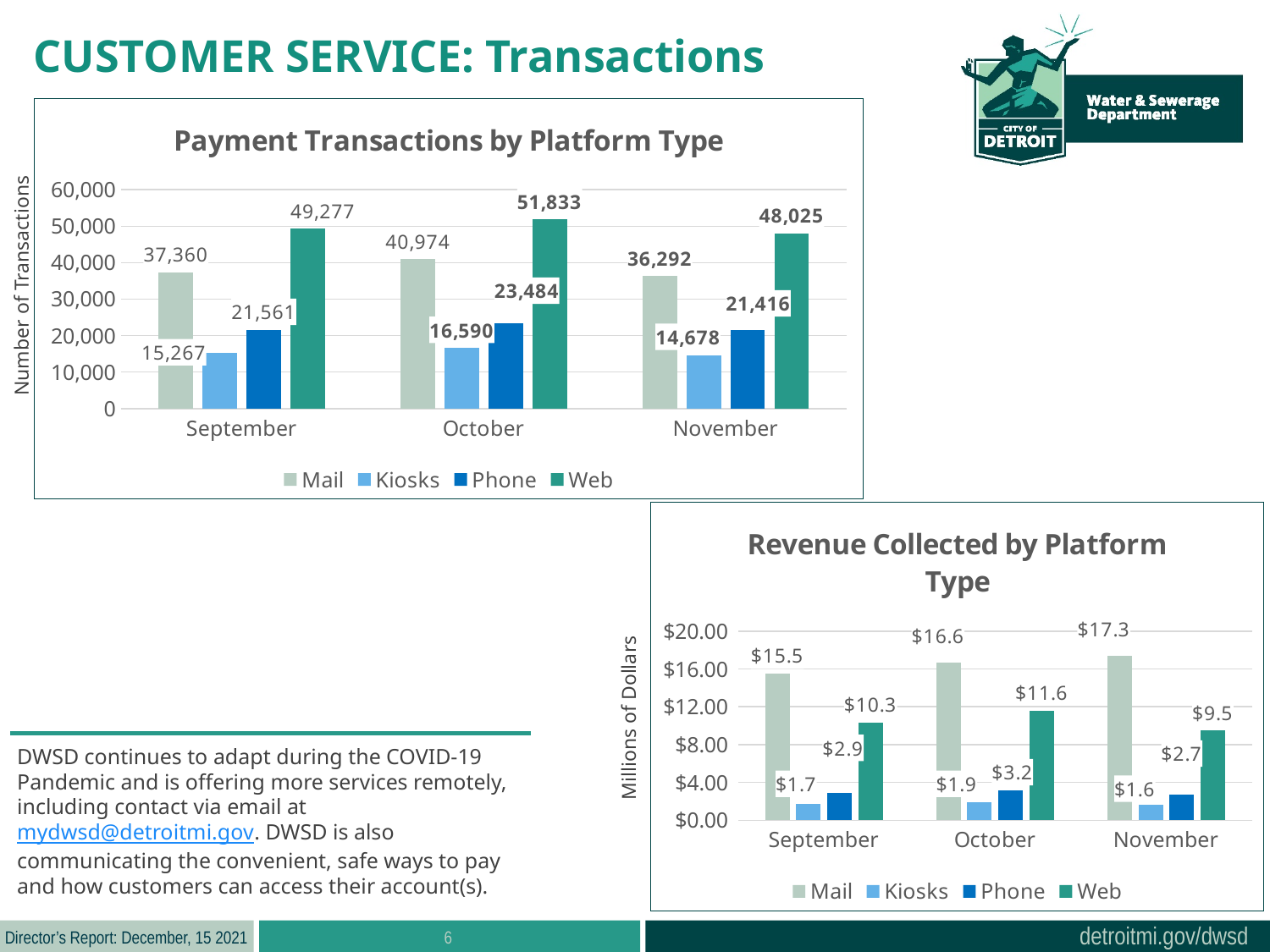
In the Revenue Collected by Platform Type chart, what is the difference between Web revenue in October and Web revenue in November? $2.1 In the Payment Transactions by Platform Type chart, how many Web transactions were there in October? 51,833 In the Payment Transactions by Platform Type chart, how many series does the legend list? 4 In the Payment Transactions by Platform Type chart, how many months are shown on the x axis? 3 In the Payment Transactions by Platform Type chart, which platform had the most transactions in September? Web In the Payment Transactions by Platform Type chart, how many Kiosks transactions were there in November? 14,678 What type of chart is the Revenue Collected by Platform Type chart? Bar chart In the Revenue Collected by Platform Type chart, how much revenue was collected via Web in November? $9.5 In the Revenue Collected by Platform Type chart, which is larger: Mail revenue in September or Mail revenue in November? Mail revenue in November In the Payment Transactions by Platform Type chart, what is the difference between Mail and Phone transactions in September? 15,799 In the Revenue Collected by Platform Type chart, how much revenue was collected via Phone in October? $3.2 In the Payment Transactions by Platform Type chart, which platform had the fewest transactions in October? Kiosks